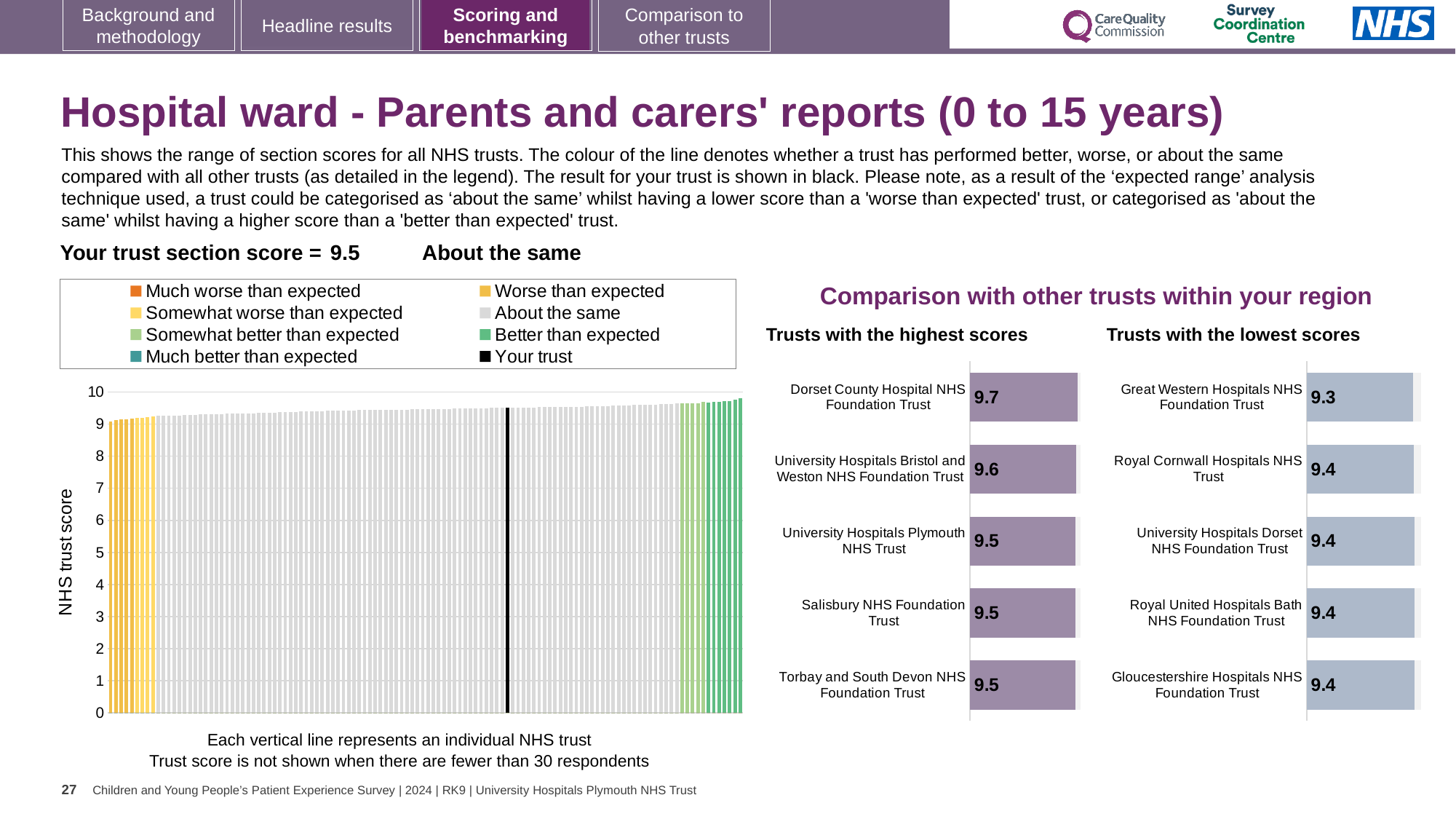
How many entries does the legend of the large chart on the left list? 8 In the large chart on the left, is the value for the black 'Your trust' line greater or less than 8? greater In the 'Trusts with the highest scores' chart, which trust has the highest score? Dorset County Hospital NHS Foundation Trust What is the difference between the score for Dorset County Hospital NHS Foundation Trust in the 'highest scores' chart and the score for Great Western Hospitals NHS Foundation Trust in the 'lowest scores' chart? 0.4 In the large chart on the left, what is the section score for your trust (the black line)? 9.5 In the 'Trusts with the highest scores' chart, what is the score for Dorset County Hospital NHS Foundation Trust? 9.7 In the 'Trusts with the highest scores' chart, what is the score for University Hospitals Bristol and Weston NHS Foundation Trust? 9.6 In the 'Trusts with the highest scores' chart, which has the larger score: Dorset County Hospital NHS Foundation Trust or Salisbury NHS Foundation Trust? Dorset County Hospital NHS Foundation Trust How many trusts are shown in the 'Trusts with the lowest scores' chart? 5 In the 'Trusts with the lowest scores' chart, which trust has the lowest score? Great Western Hospitals NHS Foundation Trust In the 'Trusts with the lowest scores' chart, what is the score for Great Western Hospitals NHS Foundation Trust? 9.3 In the 'Trusts with the lowest scores' chart, what is the score for Royal Cornwall Hospitals NHS Trust? 9.4